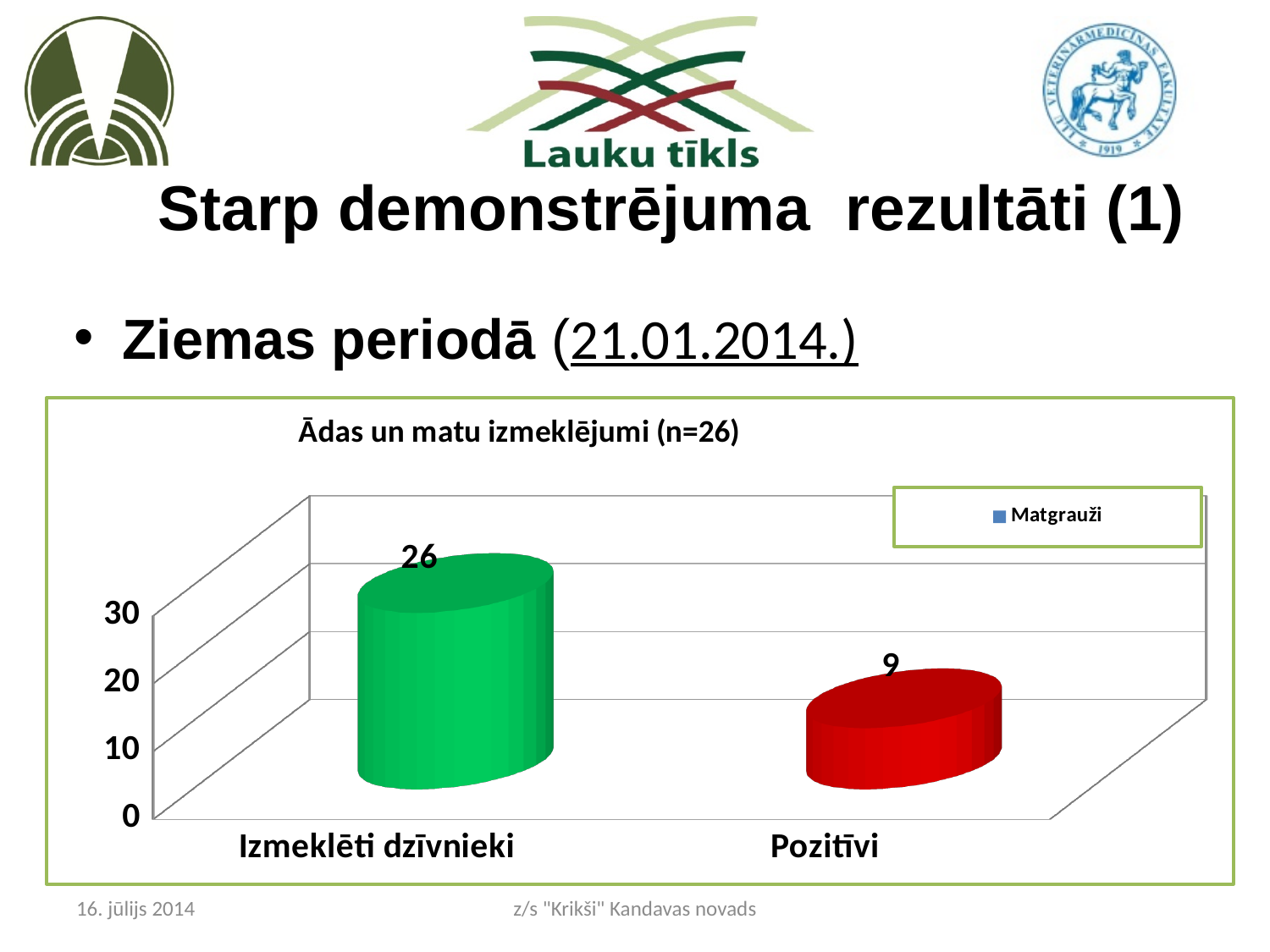
Which category has the lowest value? Pozitīvi What is the title of the chart? Ādas un matu izmeklējumi (n=26) Is the value for Izmeklēti dzīvnieki greater or less than 20? greater What is the difference between the values for Izmeklēti dzīvnieki and Pozitīvi? 17 How many series does the legend list? 1 Which is larger, the value for Izmeklēti dzīvnieki or the value for Pozitīvi? Izmeklēti dzīvnieki What is the value for Pozitīvi? 9 How many categories are shown on the x axis? 2 What is the value for Izmeklēti dzīvnieki? 26 Which category has the highest value? Izmeklēti dzīvnieki Is the value for Pozitīvi greater or less than 10? less What kind of chart is shown? bar chart